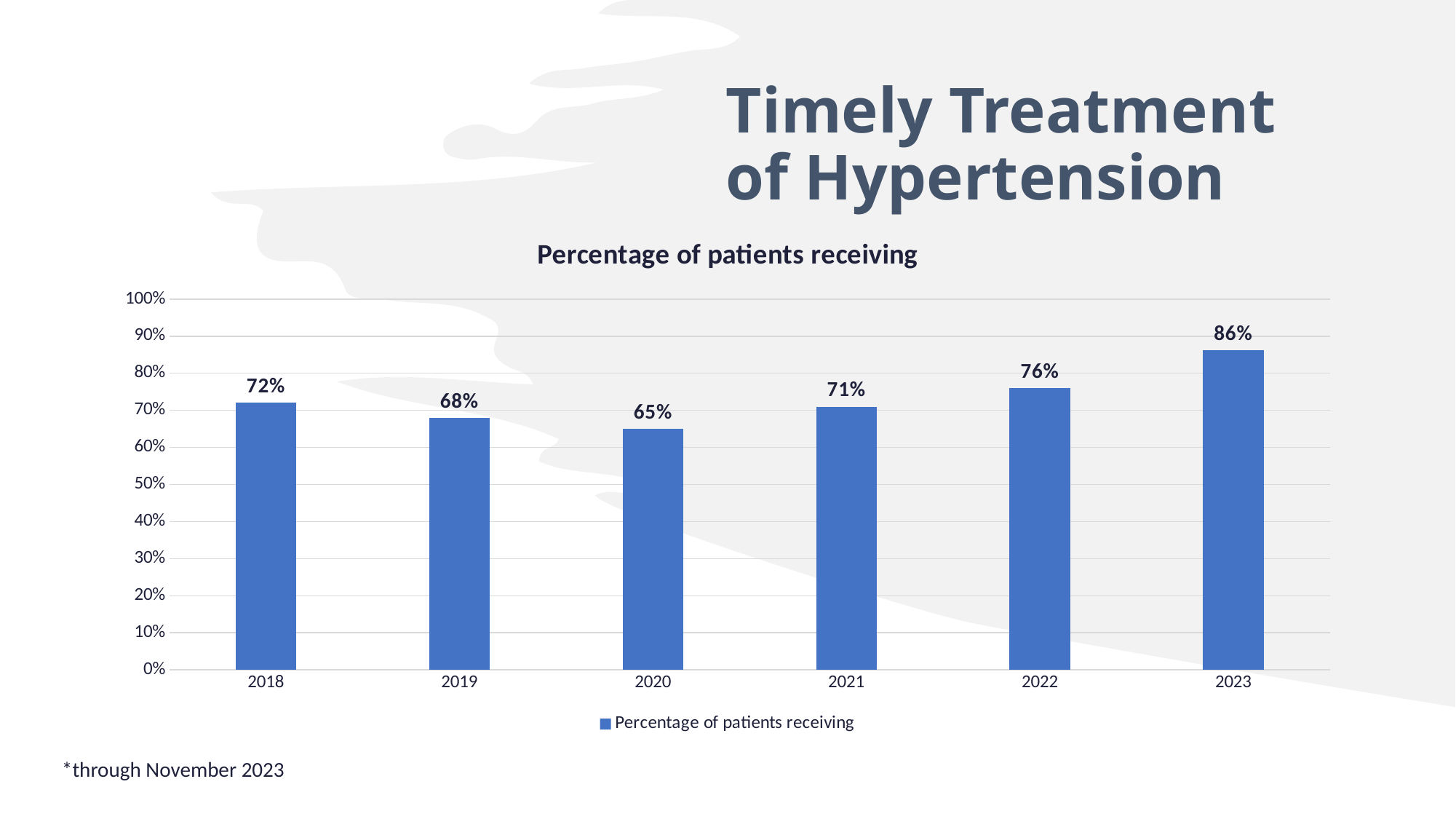
What is the value shown for 2020? 65% Which year has the highest percentage of patients receiving timely treatment? 2023 How many years are shown on the x axis? 6 What is the difference between the 2018 value and the 2019 value? 4% What kind of chart is shown on the slide? bar chart Which is larger, the value for 2021 or the value for 2019? 2021 What is the title of the chart? Percentage of patients receiving Which year has the lowest percentage of patients receiving timely treatment? 2020 What is the percentage of patients receiving timely treatment in 2018? 72% What is the difference between the 2023 value and the 2022 value? 10% What is the value shown for 2023? 86% Is the value for 2022 greater or less than 80%? less